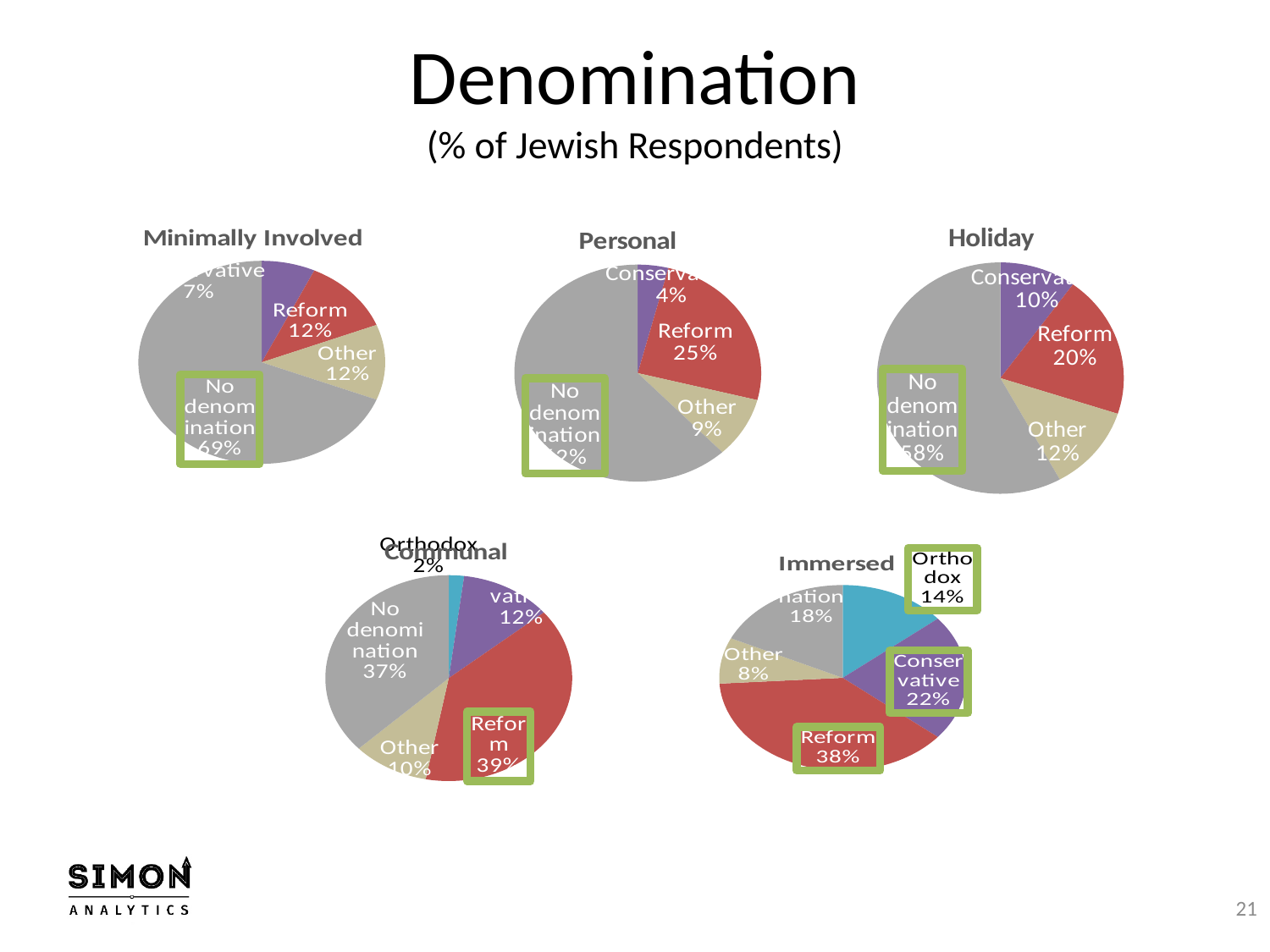
In the Minimally Involved pie chart, what percentage is No denomination? 69% In the Holiday pie chart, what percentage is Reform? 20% In the Immersed pie chart, what percentage is Orthodox? 14% In the Immersed pie chart, which denomination has the largest share? Reform In the Communal pie chart, what percentage is Reform? 39% In the Minimally Involved pie chart, what percentage is Reform? 12% In the Personal pie chart, what percentage is Other? 9% In the Immersed pie chart, what is the difference between the Reform share and the Conservative share? 16% Which is larger in the Holiday pie chart: Reform or Other? Reform In the Communal pie chart, which denomination has the smallest share? Orthodox What kind of charts are shown on the slide? Pie charts In the Personal pie chart, what percentage is Reform? 25%